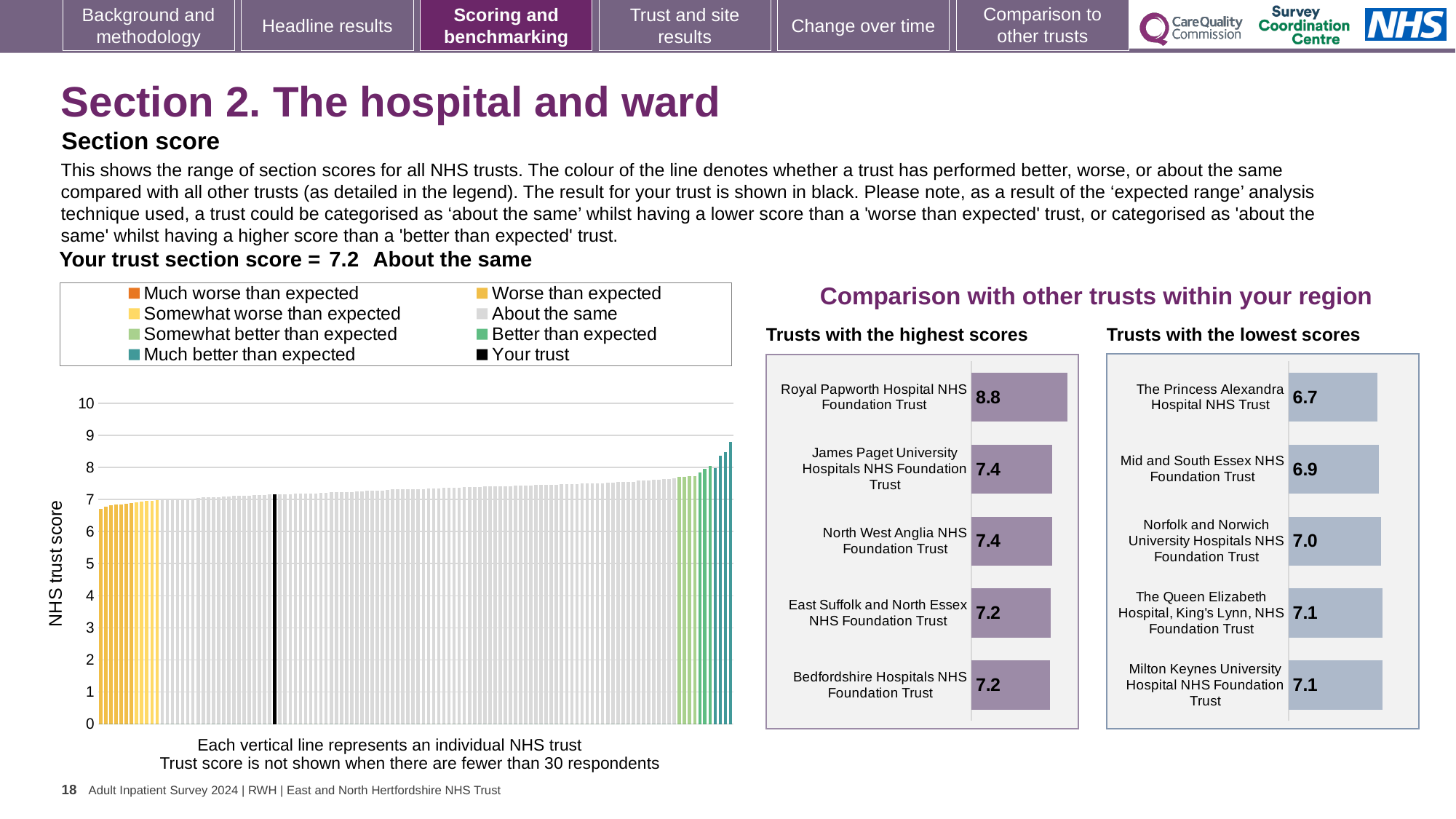
In the 'Trusts with the lowest scores' chart, what is the score for Mid and South Essex NHS Foundation Trust? 6.9 How many entries does the legend of the large 'NHS trust score' chart on the left list? 8 In the 'Trusts with the highest scores' chart, what is the difference between the scores of Royal Papworth Hospital NHS Foundation Trust and Bedfordshire Hospitals NHS Foundation Trust? 1.6 In the 'Trusts with the lowest scores' chart, what is the difference between the scores of Milton Keynes University Hospital NHS Foundation Trust and The Princess Alexandra Hospital NHS Trust? 0.4 In the large 'NHS trust score' chart on the left, is the value for the black 'Your trust' bar greater or less than 5? greater What kind of chart is the 'Trusts with the lowest scores' chart? Bar chart How many trusts are shown in the 'Trusts with the highest scores' chart? 5 In the 'Trusts with the lowest scores' chart, which trust has the lowest score? The Princess Alexandra Hospital NHS Trust In the 'Trusts with the highest scores' chart, what is the score for Royal Papworth Hospital NHS Foundation Trust? 8.8 In the 'Trusts with the highest scores' chart, which trust has the highest score? Royal Papworth Hospital NHS Foundation Trust In the large 'NHS trust score' chart on the left, do the bar heights rise or fall from left to right? Rise In the 'Trusts with the lowest scores' chart, which has the higher score: Mid and South Essex NHS Foundation Trust or Norfolk and Norwich University Hospitals NHS Foundation Trust? Norfolk and Norwich University Hospitals NHS Foundation Trust